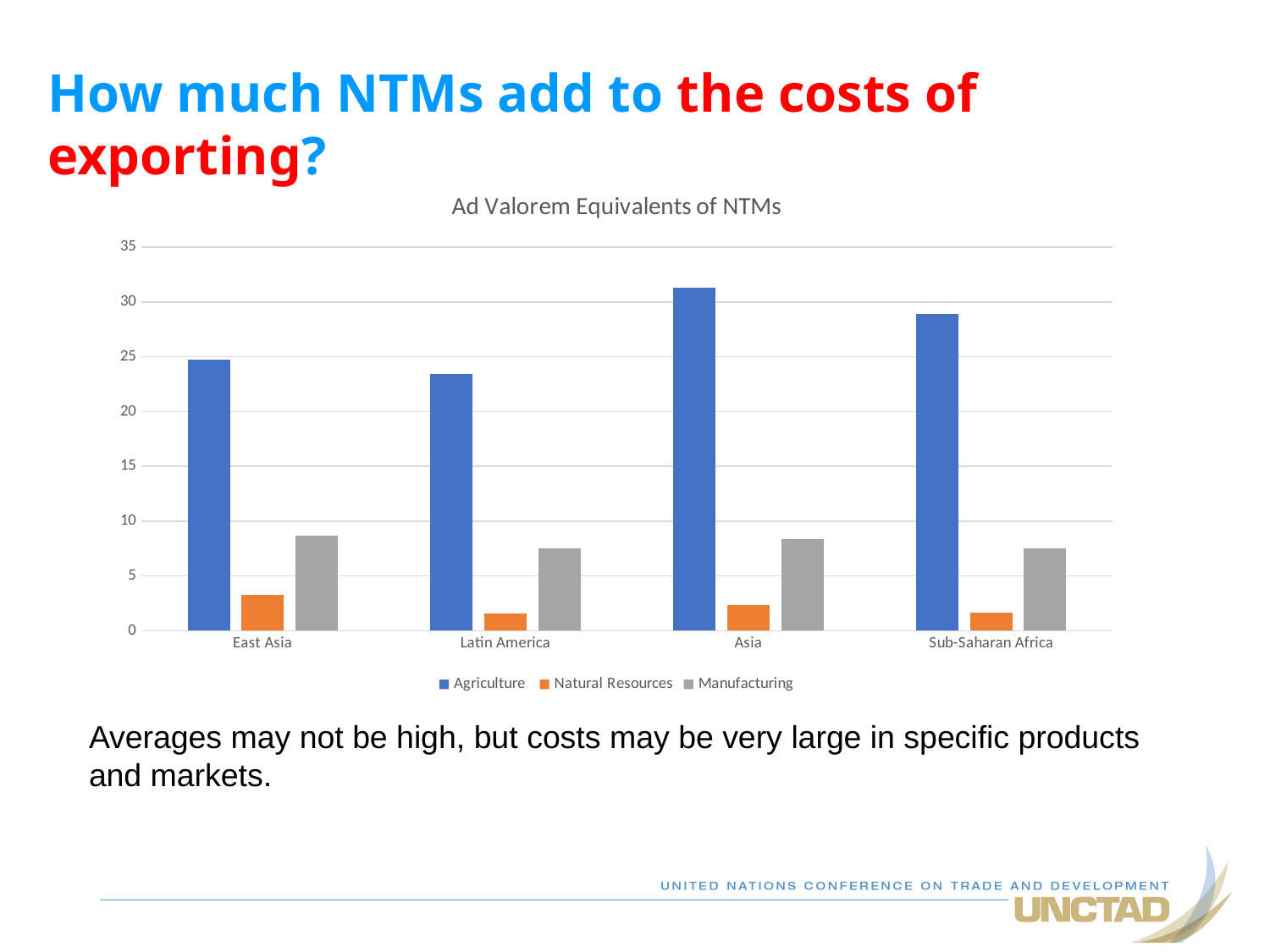
Which region has the lowest Agriculture value? Latin America Is the Agriculture value for Asia greater or less than 30? greater How many regions are shown on the x axis? 4 For Latin America, which is larger: the Agriculture value or the Manufacturing value? Agriculture Is the Agriculture value for Sub-Saharan Africa greater or less than 30? less Is the Manufacturing value for East Asia greater or less than 10? less What type of chart is shown on the slide? bar chart Which region has the highest Natural Resources value? East Asia What is the title of the chart? Ad Valorem Equivalents of NTMs How many series does the legend list? 3 Which region has the highest Agriculture value? Asia